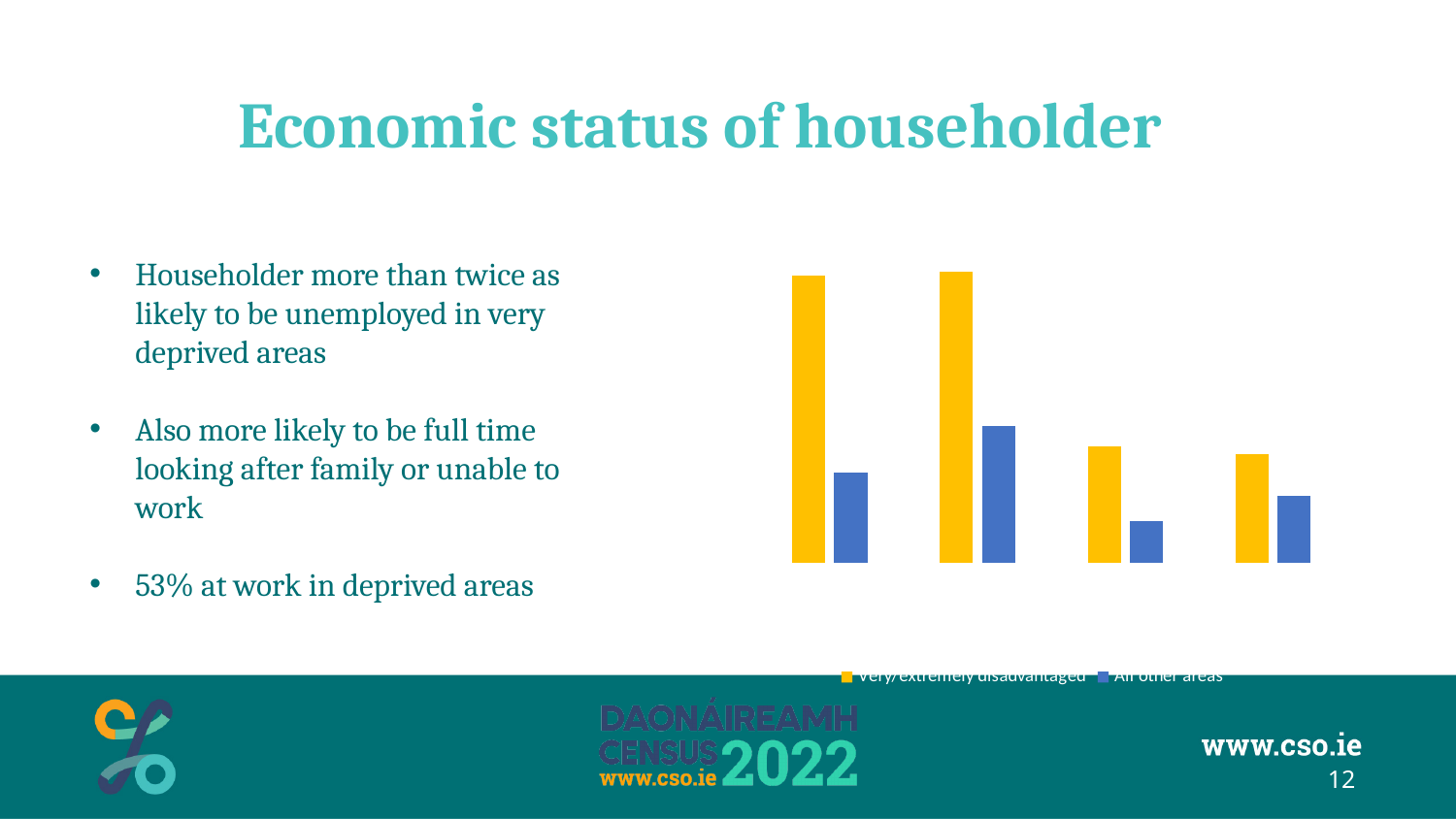
Which series is shown in yellow in the chart? Very/extremely disadvantaged How many groups of bars are plotted in the chart? 4 Which series has the shortest bar in the chart? All other areas What kind of chart is shown on the slide? bar chart In the leftmost group of bars, which series has the taller bar? Very/extremely disadvantaged How many series does the chart's legend list? 2 In the rightmost group of bars, which series has the taller bar? Very/extremely disadvantaged Which series has the tallest bar in the chart? Very/extremely disadvantaged In the third group of bars from the left, is the Very/extremely disadvantaged bar taller or shorter than the All other areas bar? taller Which series is shown in blue in the chart? All other areas